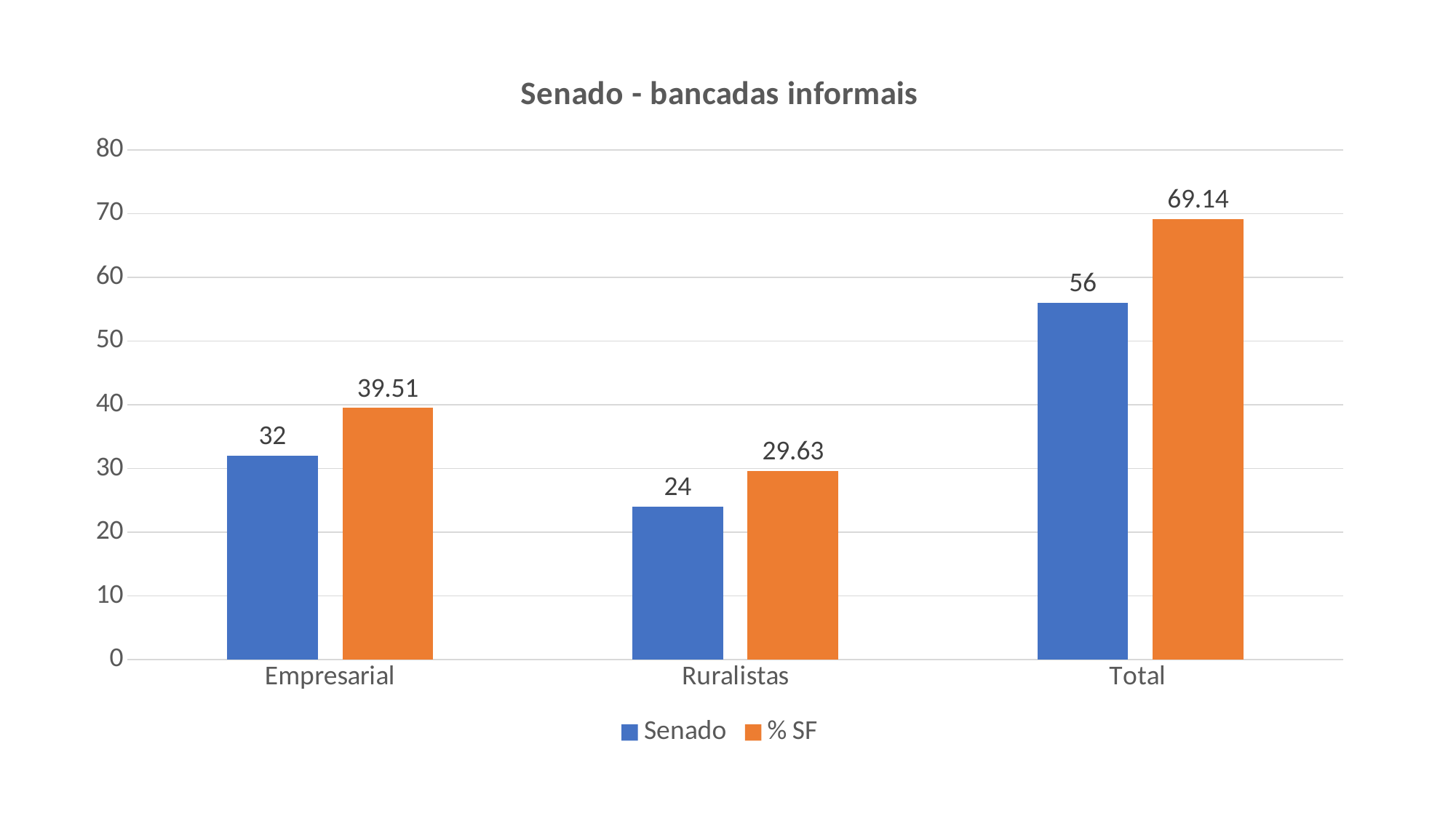
How many series does the legend list? 2 How many categories are shown on the x axis? 3 What type of chart is shown on the slide? Bar chart What is the Senado value for Ruralistas? 24 Is the Senado value for Total greater or less than 50? greater What is the Senado value for Empresarial? 32 Which category has the highest Senado value? Total What is the % SF value for Ruralistas? 29.63 Which category has the lowest % SF value? Ruralistas Which is larger for Empresarial, the Senado value or the % SF value? % SF What is the difference between the Senado values for Empresarial and Ruralistas? 8 What is the % SF value for Total? 69.14